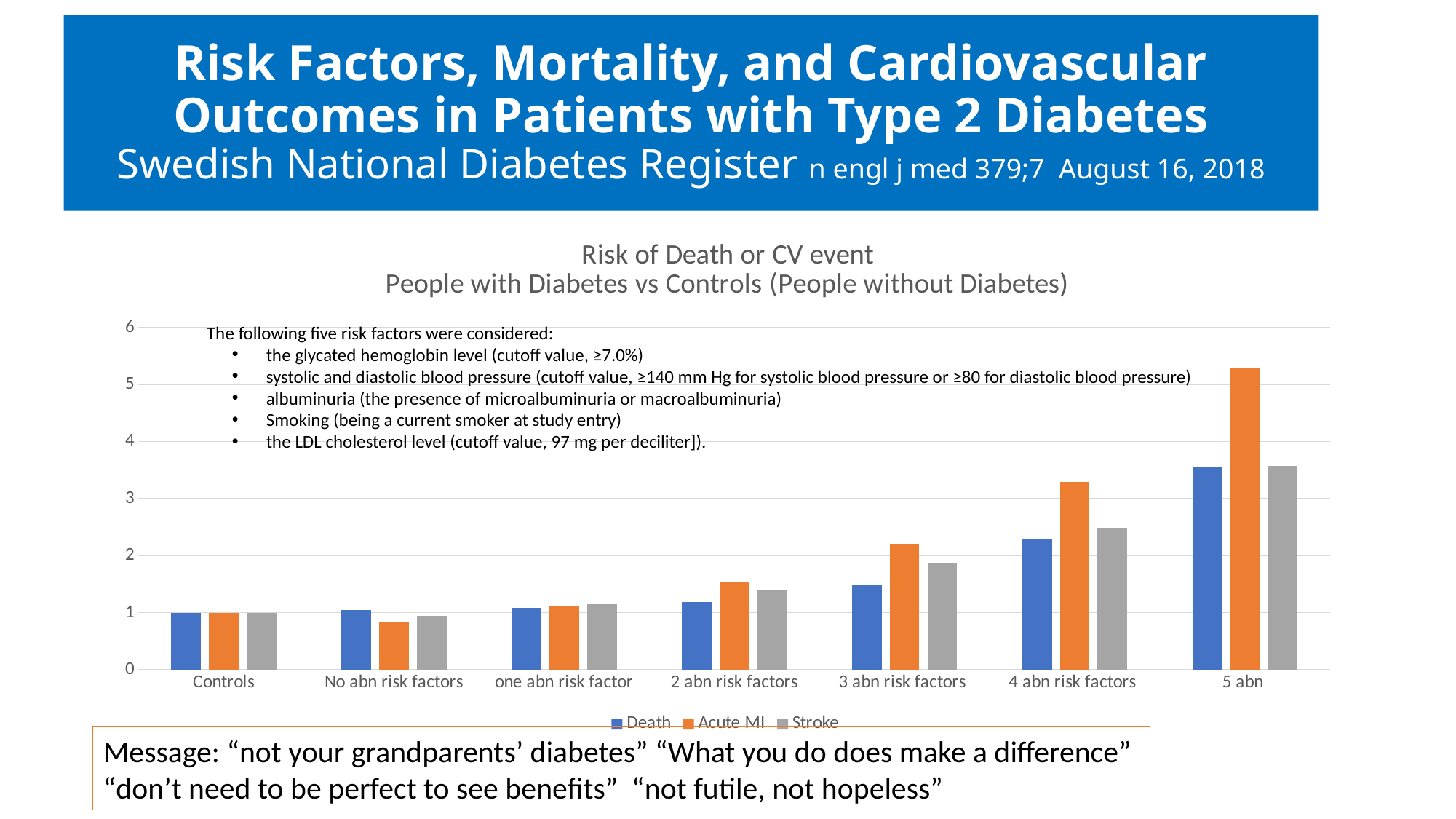
Which category has the lowest Acute MI value? No abn risk factors How many series does the legend list? 3 Do the Death values rise or fall moving from Controls to 5 abn along the x axis? rise What kind of chart is shown on the slide? bar chart Is the Death value for 4 abn risk factors greater or less than 2? greater Is the Acute MI value for 5 abn greater or less than 5? greater In the 3 abn risk factors category, which is larger: Acute MI or Death? Acute MI What is the value for Stroke in the Controls category? 1 How many categories are shown on the x axis? 7 Which category has the highest Acute MI value? 5 abn Is the Acute MI value for No abn risk factors greater or less than 1? less What is the value for Death in the Controls category? 1